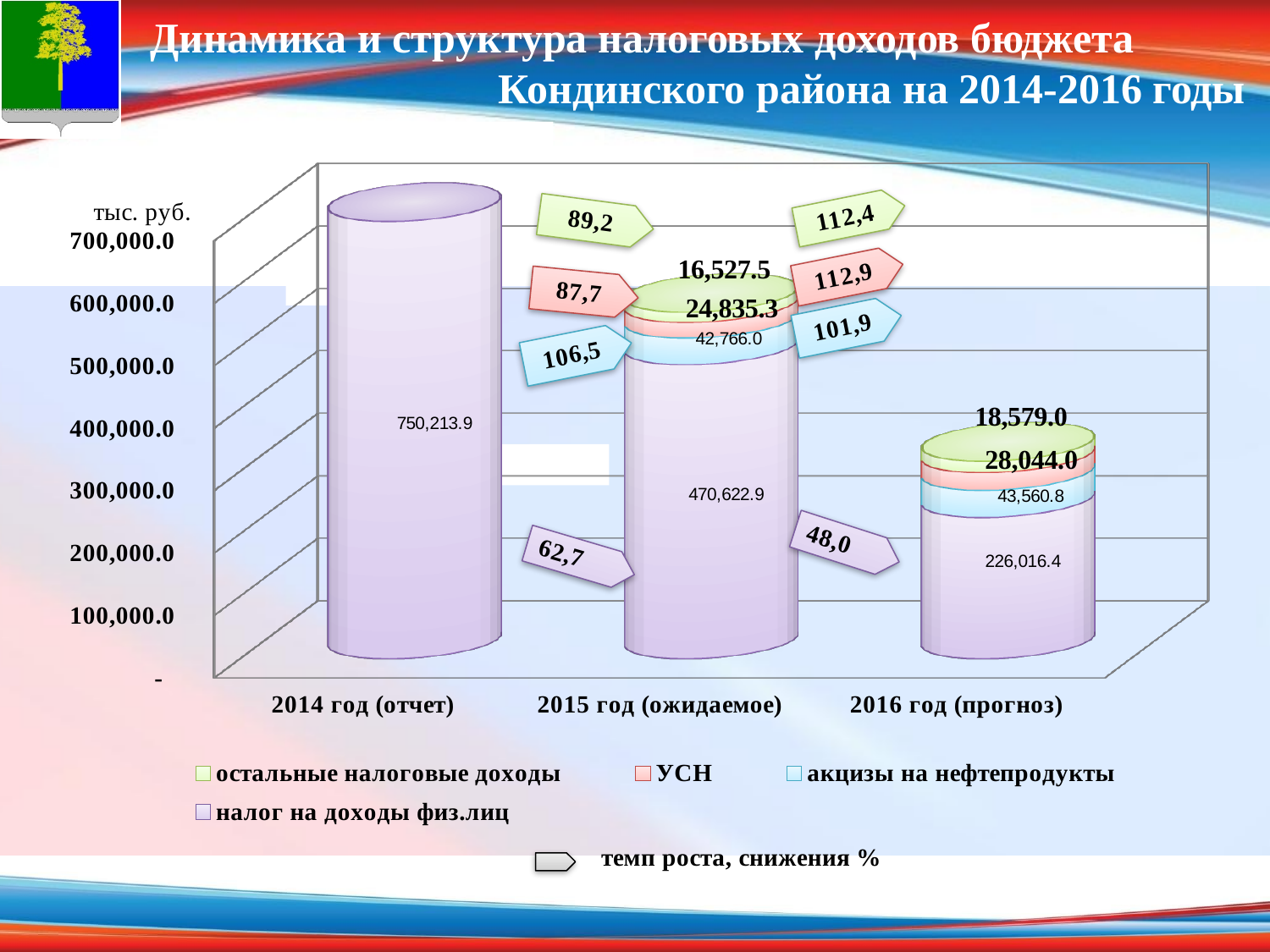
What is the value of УСН for 2016 год (прогноз)? 28,044.0 What is the total of the stacked bar for 2016 год (прогноз)? 316,200.2 Which is larger: УСН in 2015 год (ожидаемое) or УСН in 2016 год (прогноз)? 2016 год (прогноз) What is the value of акцизы на нефтепродукты for 2015 год (ожидаемое)? 42,766.0 How many series does the legend list? 4 What is the difference between налог на доходы физ.лиц in 2015 год (ожидаемое) and in 2016 год (прогноз)? 244,606.5 In which year is the value of налог на доходы физ.лиц the highest? 2014 год (отчет) What kind of chart is shown on the slide? Stacked bar chart Does the value of налог на доходы физ.лиц rise or fall from 2014 to 2016? Fall What is the value of налог на доходы физ.лиц for 2016 год (прогноз)? 226,016.4 What is the value of остальные налоговые доходы for 2015 год (ожидаемое)? 16,527.5 What is the value of налог на доходы физ.лиц for 2014 год (отчет)? 750,213.9